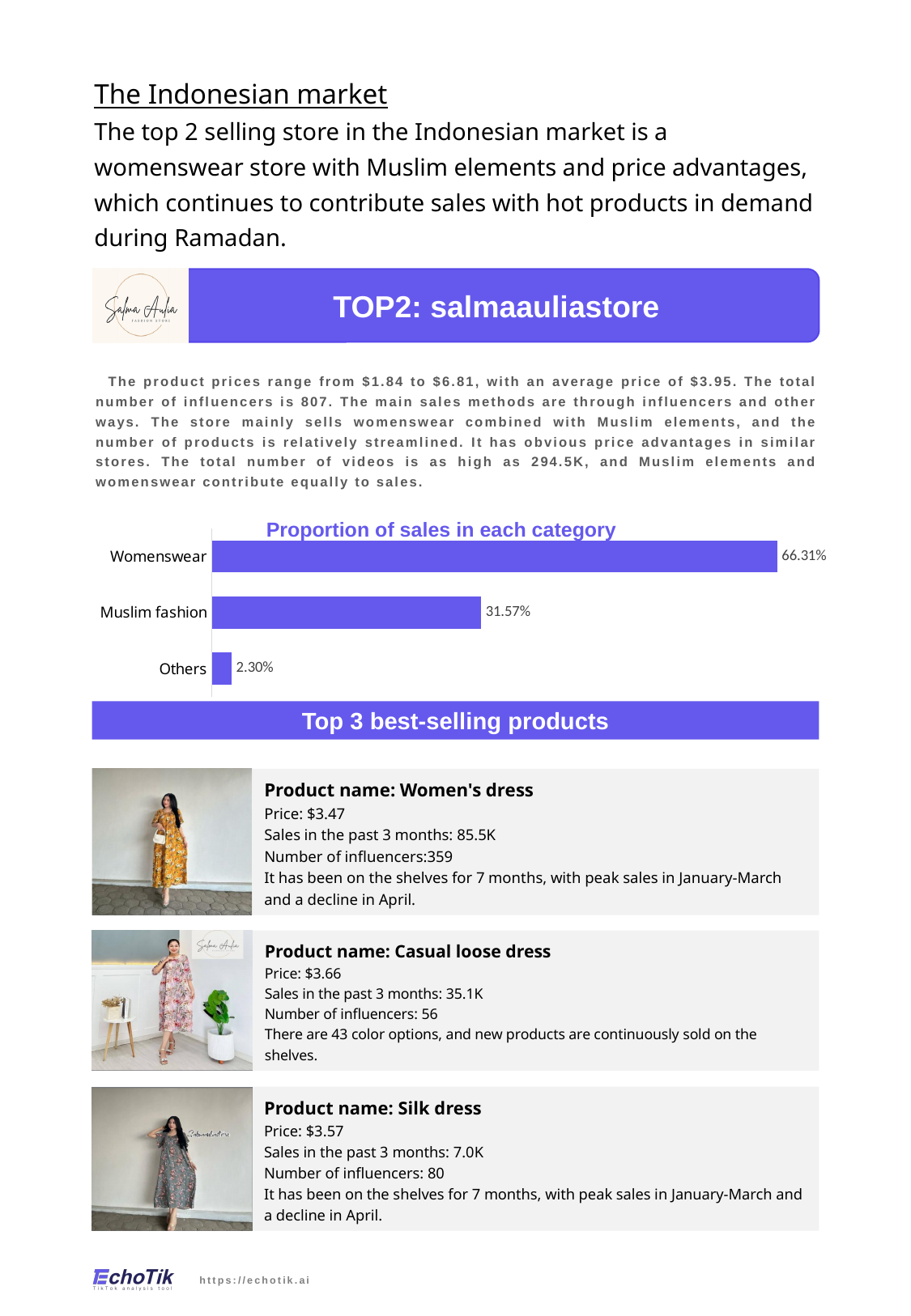
What is the title of the chart on the slide? Proportion of sales in each category Which category has the lowest proportion of sales? Others What is the proportion of sales for Others? 2.30% What is the proportion of sales for Womenswear? 66.31% Which has a larger proportion of sales, Muslim fashion or Others? Muslim fashion What colour are the bars in the chart? purple How many categories are shown in the chart? 3 What type of chart is used to show the proportion of sales in each category? bar chart What is the proportion of sales for Muslim fashion? 31.57% Which category has the highest proportion of sales? Womenswear What is the difference in sales proportion between Muslim fashion and Others? 29.27% What is the difference in sales proportion between Womenswear and Muslim fashion? 34.74%